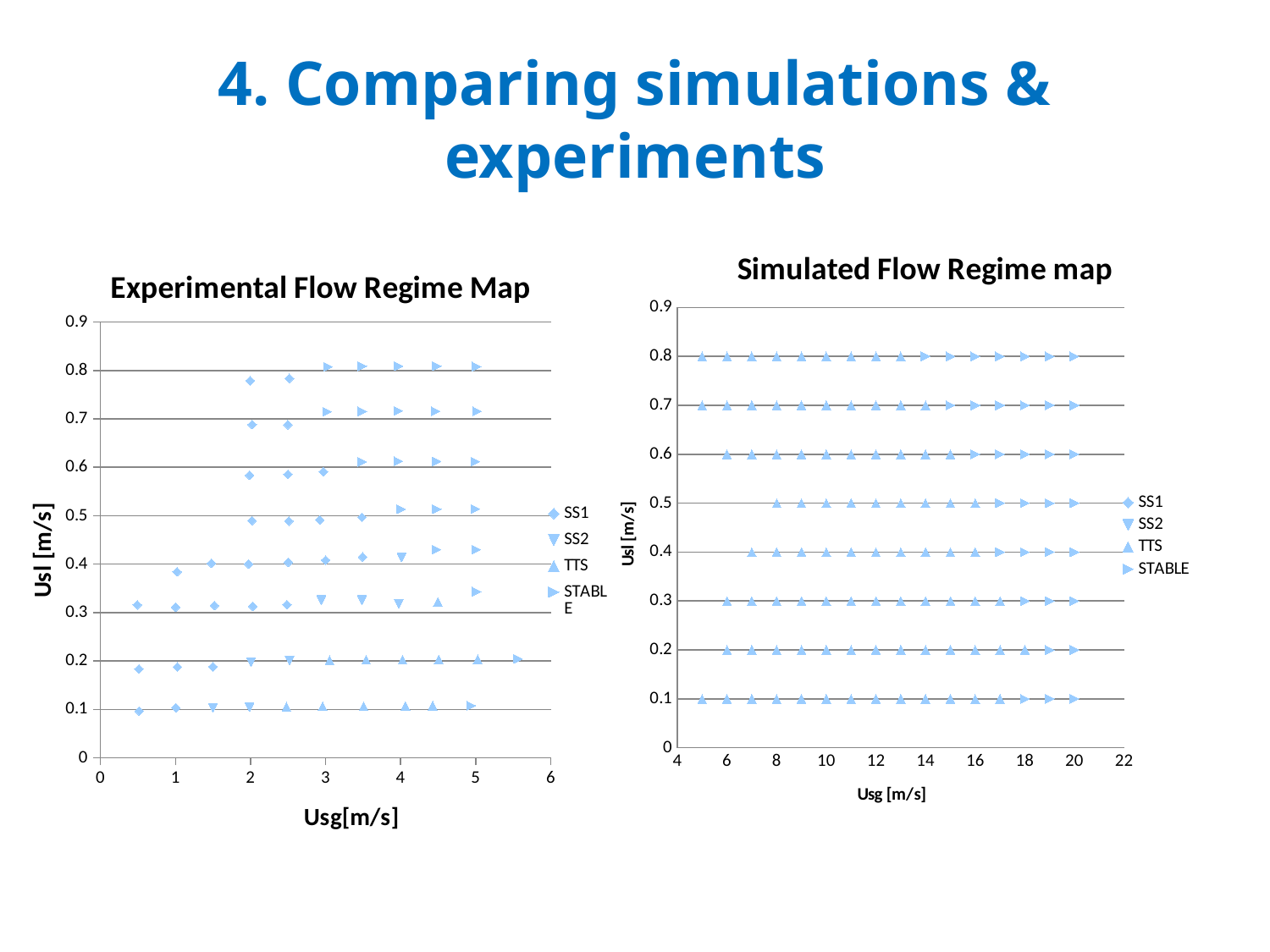
In the "Simulated Flow Regime map", what is the label of the x axis? Usg [m/s] In the "Simulated Flow Regime map", is the largest Usg value plotted greater or less than 22? less How many series does the legend of the "Simulated Flow Regime map" list? 4 What kind of chart is the "Experimental Flow Regime Map"? Scatter chart How many series does the legend of the "Experimental Flow Regime Map" list? 4 What kind of chart is the "Simulated Flow Regime map"? Scatter chart What is the title of the chart on the left of the slide? Experimental Flow Regime Map In the "Experimental Flow Regime Map", is the lowest Usl value plotted greater or less than 0.2? less In the "Experimental Flow Regime Map", is the highest Usl value plotted greater or less than 0.7? greater